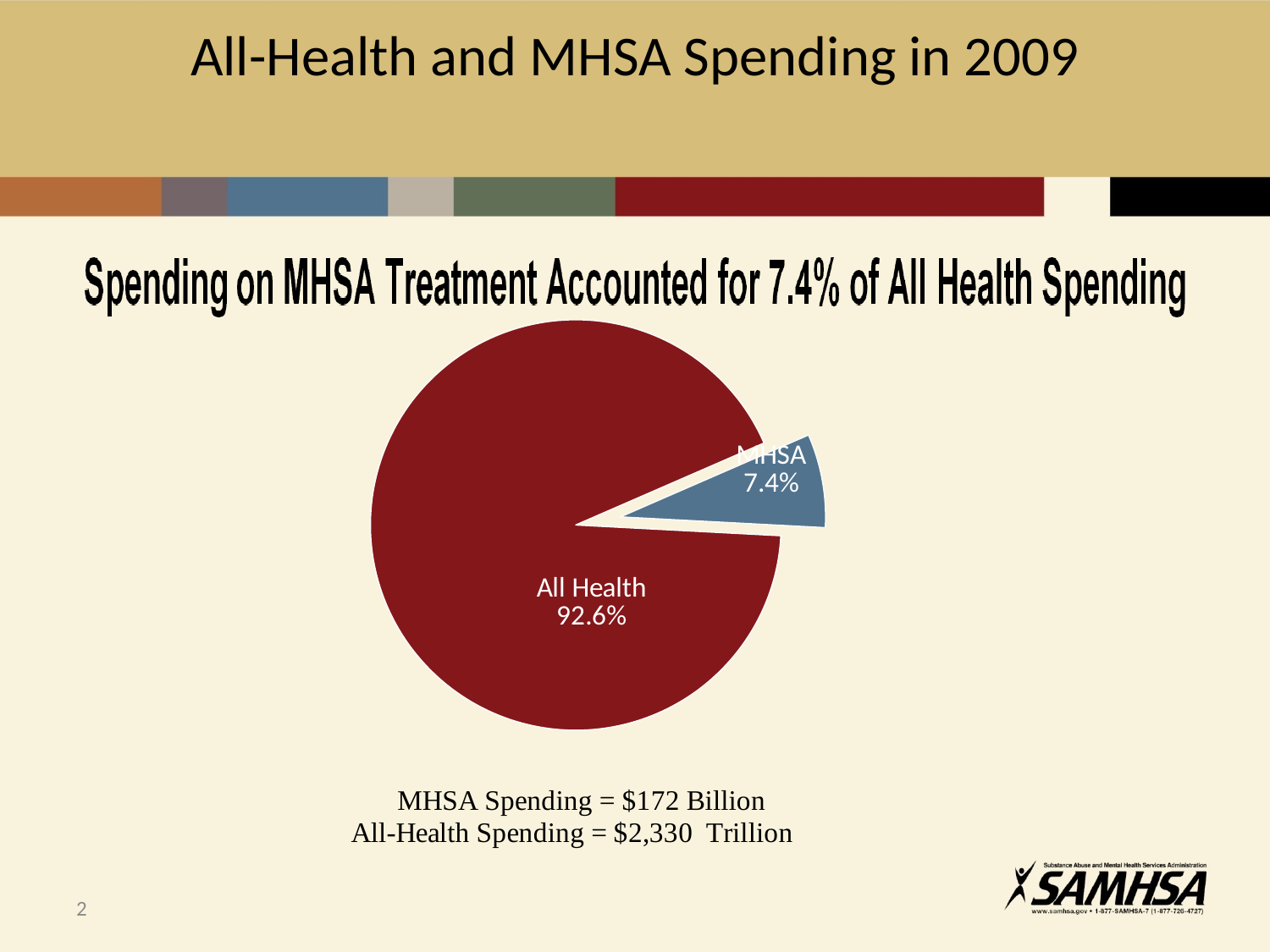
What is the title of the chart? Spending on MHSA Treatment Accounted for 7.4% of All Health Spending How many slices does the pie chart have? 2 What share of the pie does MHSA account for? 7.4% What kind of chart is shown on the slide? pie chart What colour is the MHSA slice? blue According to the text below the chart, what was All-Health spending? $2,330 Trillion According to the text below the chart, what was MHSA spending? $172 Billion Which slice of the pie is the smallest? MHSA Which is larger, the All Health slice or the MHSA slice? All Health What is the difference in percentage points between the All Health slice and the MHSA slice? 85.2 Which slice of the pie is the largest? All Health What share of the pie does All Health account for? 92.6%